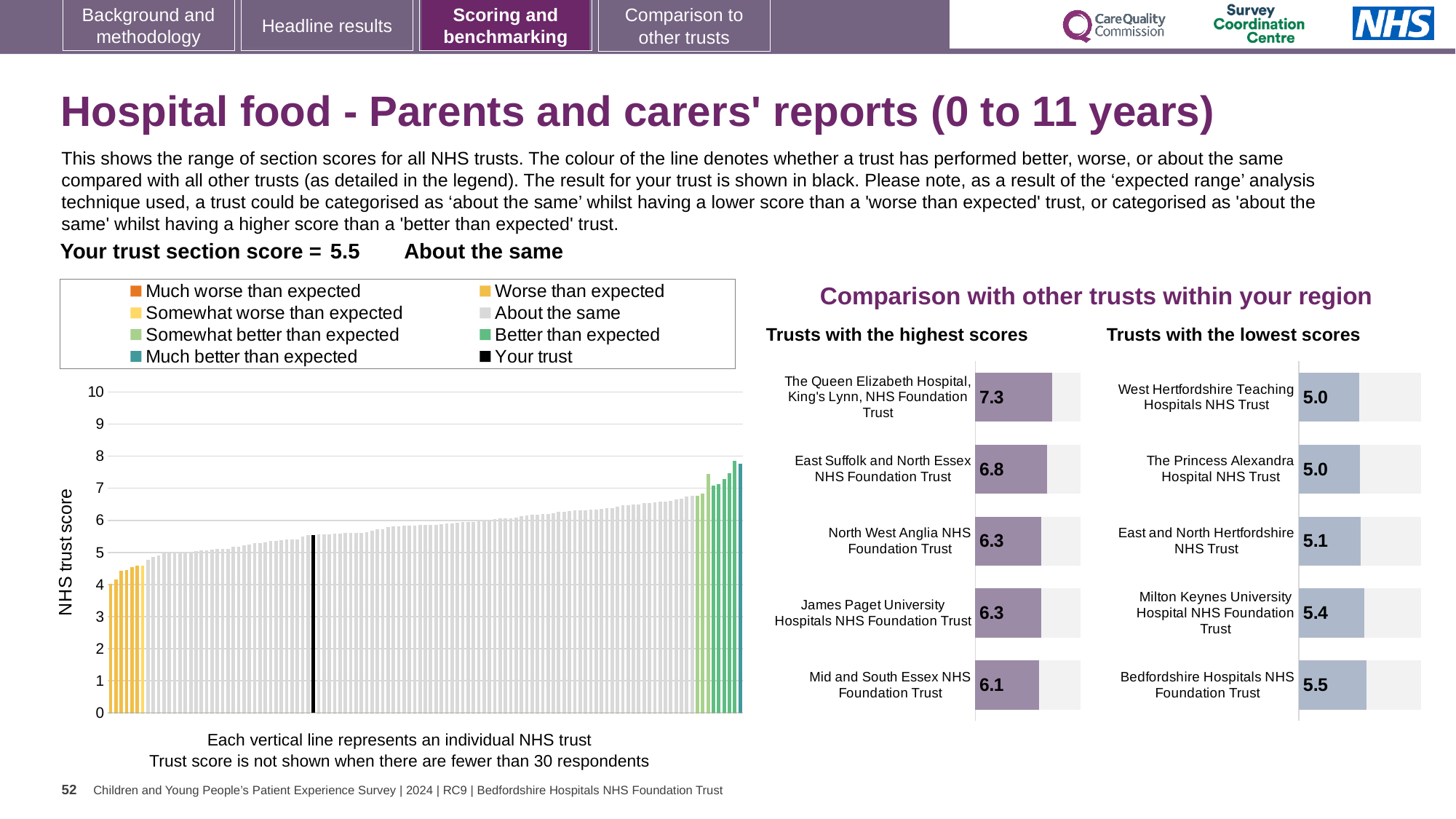
How many entries does the legend of the large chart on the left list? 8 In the 'Trusts with the highest scores' chart, how many trusts are shown? 5 In the 'Trusts with the lowest scores' chart, what is the difference between the scores of Bedfordshire Hospitals NHS Foundation Trust and West Hertfordshire Teaching Hospitals NHS Trust? 0.5 In the 'Trusts with the highest scores' chart, which trust has the highest score? The Queen Elizabeth Hospital, King's Lynn, NHS Foundation Trust What kind of chart is the large chart on the left showing NHS trust scores? Bar chart In the 'Trusts with the highest scores' chart, what is the score for East Suffolk and North Essex NHS Foundation Trust? 6.8 In the 'Trusts with the lowest scores' chart, which trust has the highest score? Bedfordshire Hospitals NHS Foundation Trust In the large chart on the left, do the trust scores rise or fall from left to right? Rise In the 'Trusts with the lowest scores' chart, what is the score for Milton Keynes University Hospital NHS Foundation Trust? 5.4 In the 'Trusts with the highest scores' chart, what is the difference between the scores of The Queen Elizabeth Hospital, King's Lynn, NHS Foundation Trust and Mid and South Essex NHS Foundation Trust? 1.2 In the 'Trusts with the highest scores' chart, what is the score for The Queen Elizabeth Hospital, King's Lynn, NHS Foundation Trust? 7.3 In the 'Trusts with the lowest scores' chart, which has the larger score: Milton Keynes University Hospital NHS Foundation Trust or East and North Hertfordshire NHS Trust? Milton Keynes University Hospital NHS Foundation Trust